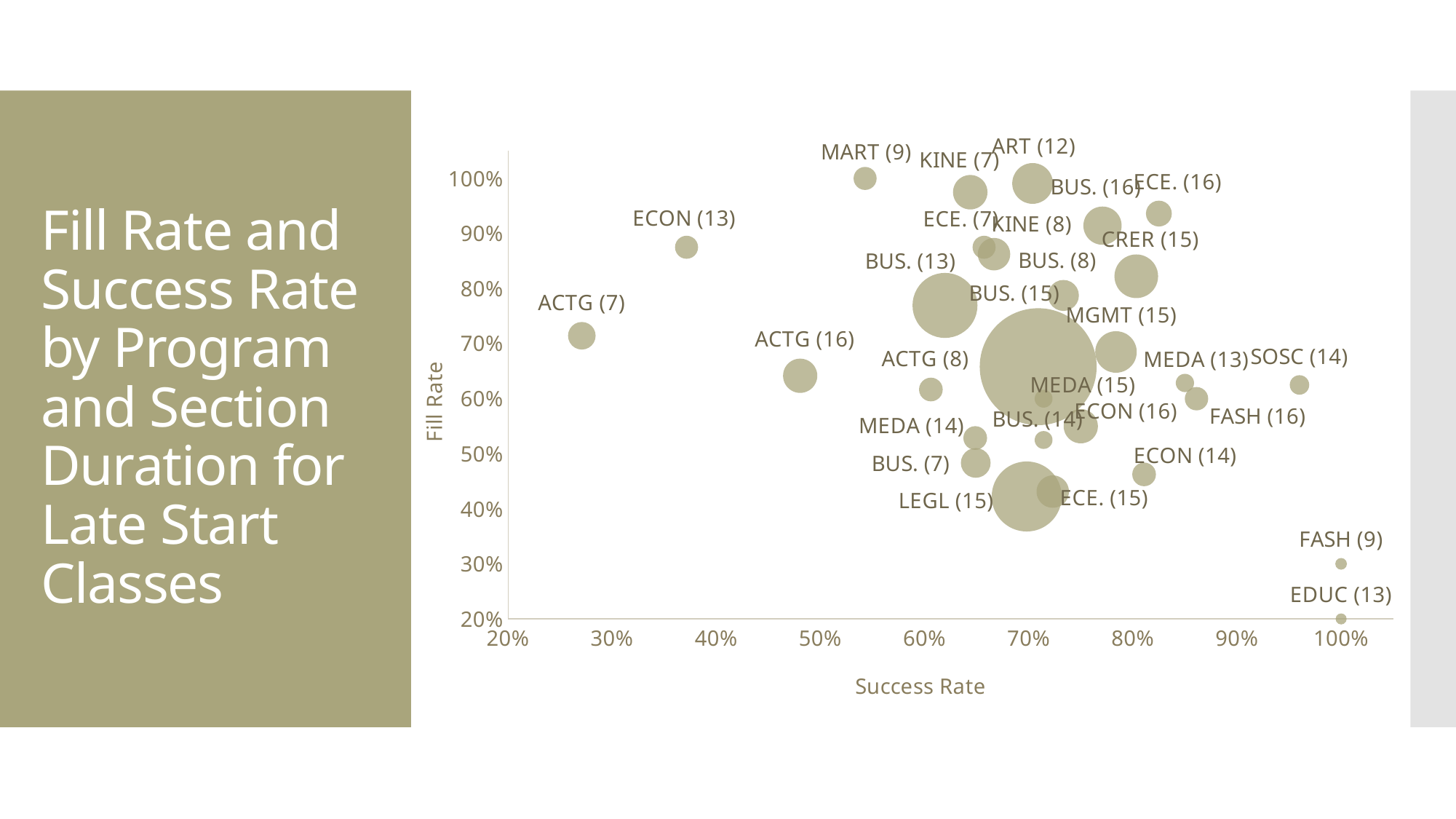
What is the fill rate for FASH (9)? 30% What is the success rate for EDUC (13)? 100% Which program has the lowest fill rate? EDUC (13) What is the label of the y axis? Fill Rate Which program has the lowest success rate? ACTG (7) What is the fill rate for EDUC (13)? 20% What kind of chart is shown on the slide? Bubble chart Is the fill rate for ECON (13) greater or less than 80%? greater Which has the higher fill rate, ACTG (7) or ECON (13)? ECON (13) Is the fill rate for LEGL (15) greater or less than 50%? less What is the fill rate for MART (9)? 100% What is the label of the x axis? Success Rate